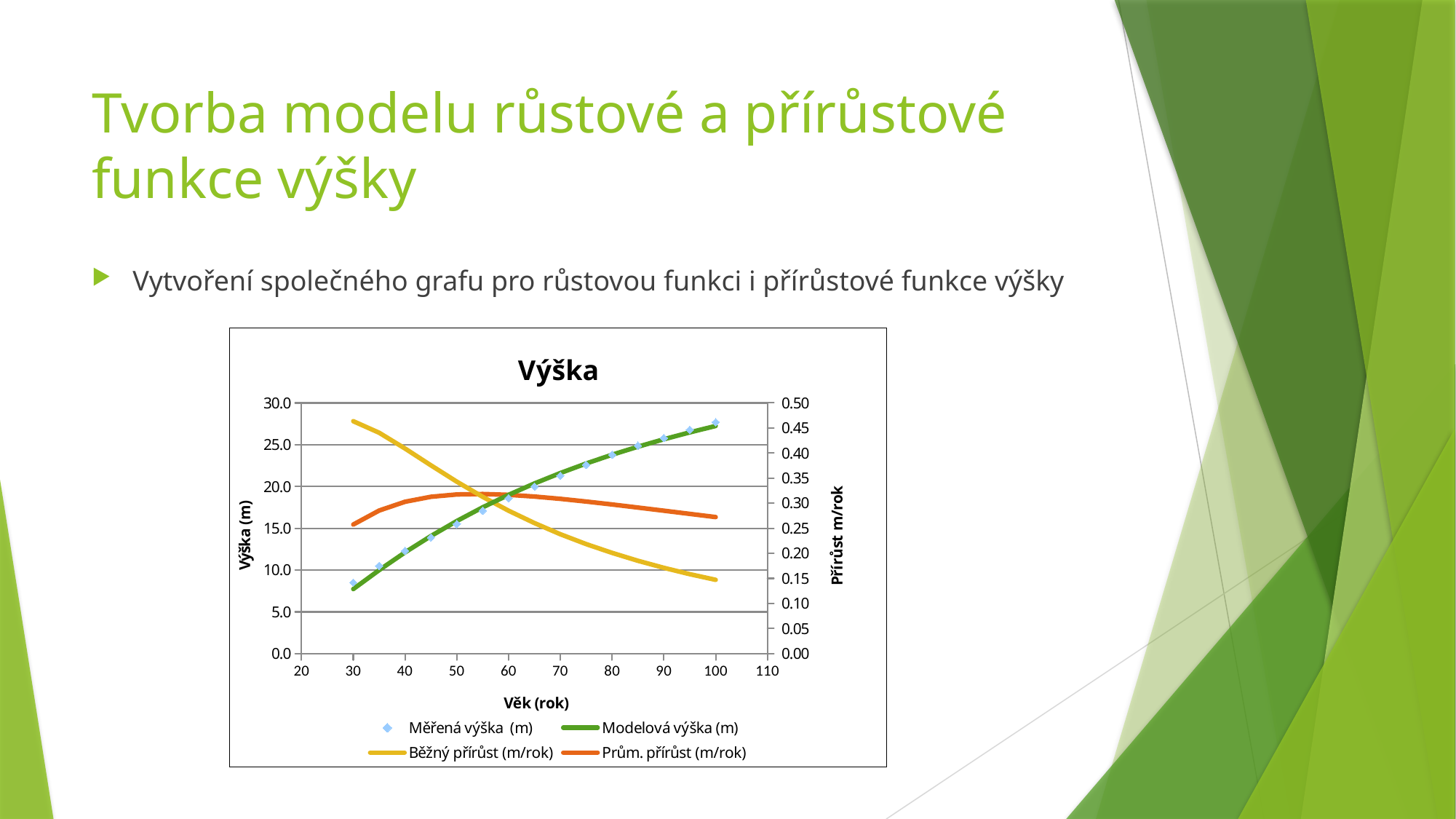
Is the Měřená výška value at age 30 greater or less than 10.0 m? less Is the Měřená výška value at age 100 greater or less than 25.0 m? greater How many series does the chart legend list? 4 What kind of chart is shown on the slide? line chart Does the Běžný přírůst (m/rok) series rise or fall as age increases along the x axis? falls How many measured points (Měřená výška) are plotted on the chart? 15 What is the label of the x axis of the chart? Věk (rok) What is the title of the chart? Výška Does the Měřená výška (m) series rise or fall as age increases along the x axis? rises Is the Běžný přírůst value at age 30 greater or less than 0.40 m/rok? greater At age 30, which is larger: Běžný přírůst (m/rok) or Prům. přírůst (m/rok)? Běžný přírůst (m/rok)